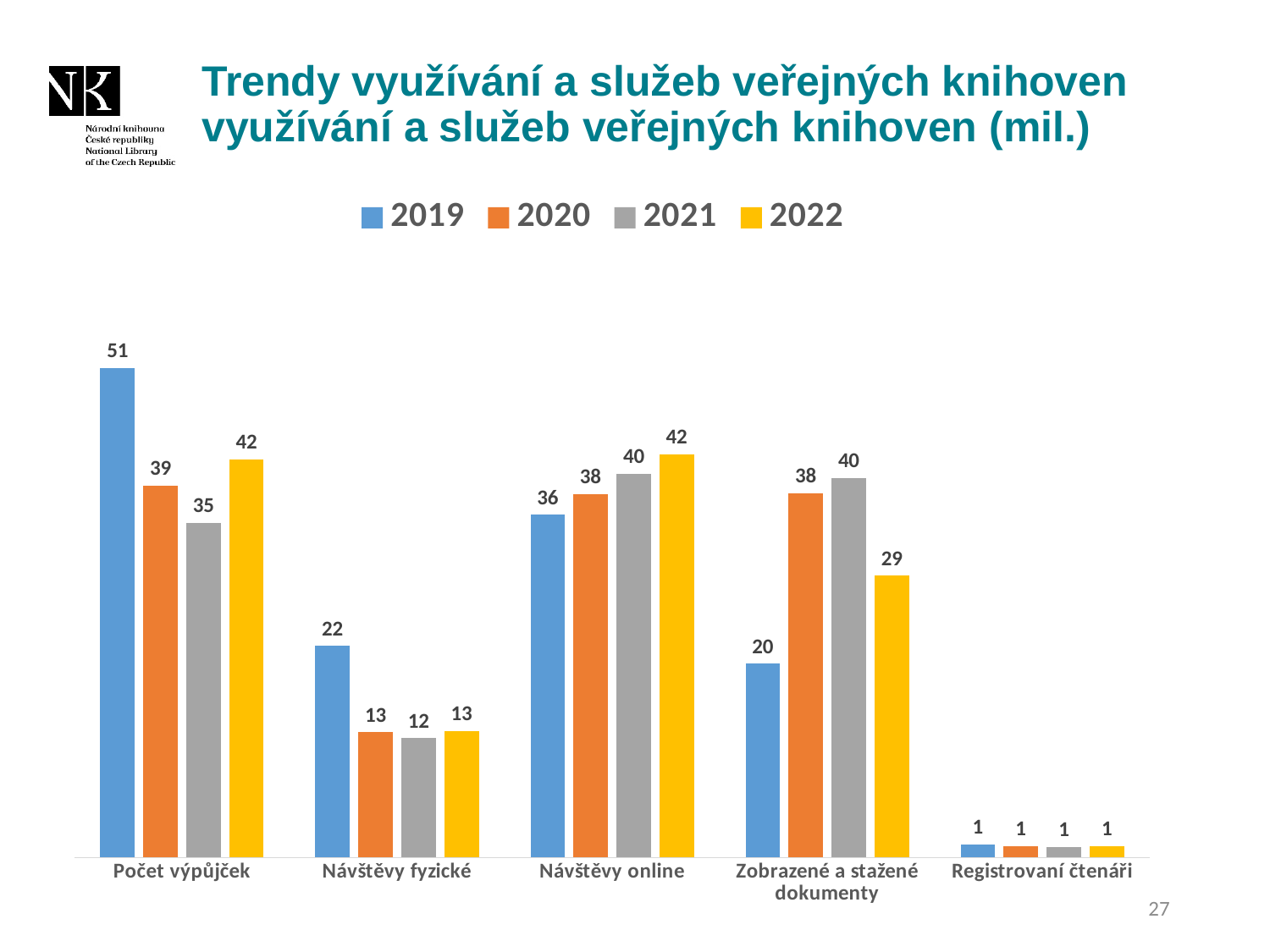
What is the value for Návštěvy fyzické in 2021? 12 Which is larger for Zobrazené a stažené dokumenty: the 2021 value or the 2022 value? 2021 What kind of chart is shown on the slide? bar chart Which category has the lowest value in 2022? Registrovaní čtenáři What is the value for Návštěvy online in 2022? 42 How many categories are shown on the x axis? 5 Which category has the highest value in 2019? Počet výpůjček What is the value for Počet výpůjček in 2019? 51 What is the value for Zobrazené a stažené dokumenty in 2020? 38 Do the values for Návštěvy online rise or fall from 2019 to 2022? rise How many series does the legend list? 4 What is the difference between the 2019 and 2022 values for Počet výpůjček? 9